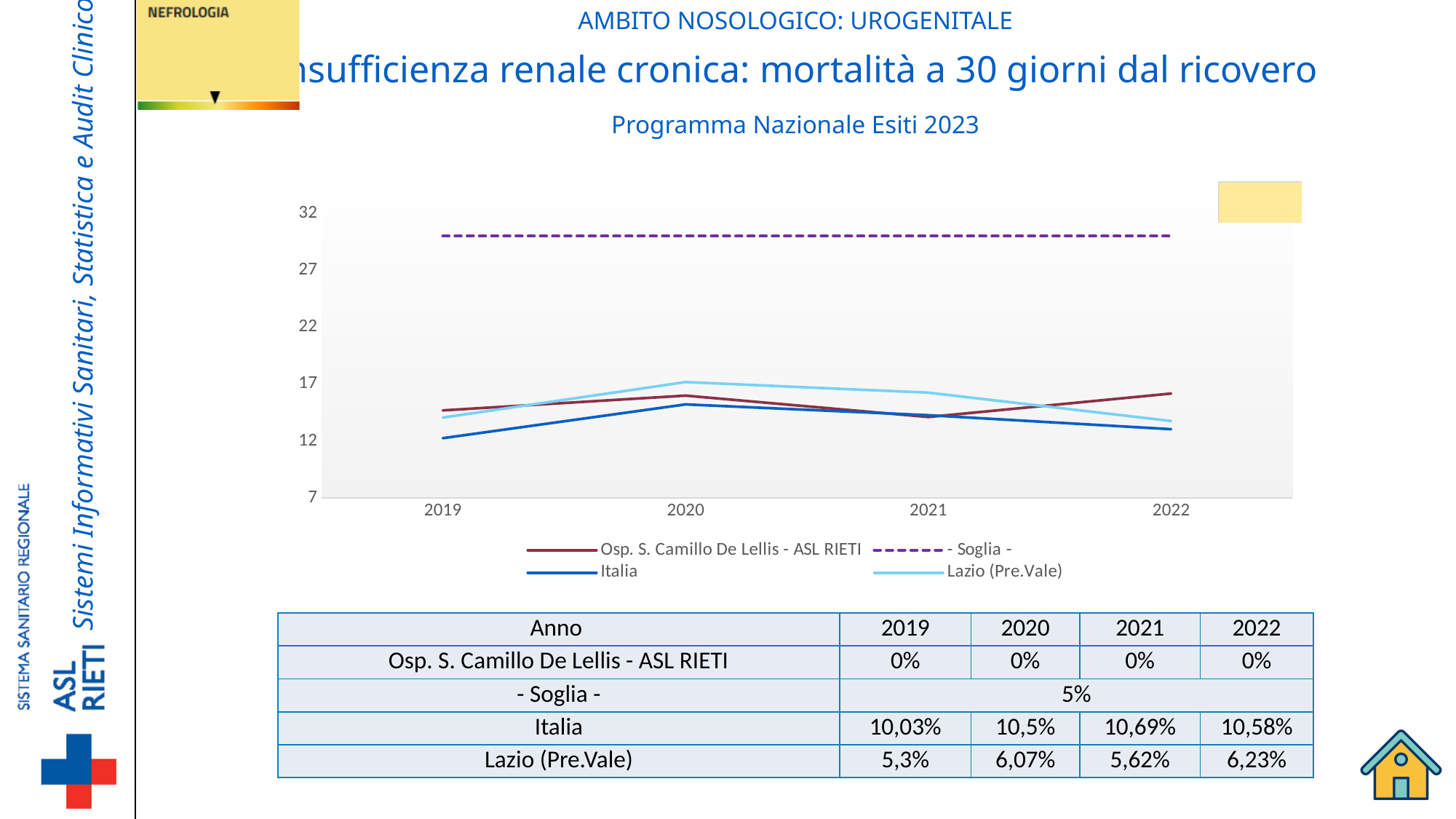
Is the value for Italia in 2019 greater or less than 17? less In which year does the Lazio (Pre.Vale) line reach its highest point? 2020 Which series has the highest values across all years in the chart? - Soglia - How many series does the chart legend list? 4 In 2019, which is higher: Osp. S. Camillo De Lellis - ASL RIETI or Italia? Osp. S. Camillo De Lellis - ASL RIETI Which series in the legend is drawn with a dashed line? - Soglia - Is the value of the - Soglia - line greater or less than 27? greater Does the Italia line rise or fall from 2019 to 2020? rise Is the value for Lazio (Pre.Vale) in 2020 greater or less than 12? greater In which year does the Italia line reach its lowest point? 2019 How many years are shown on the x axis of the chart? 4 What kind of chart is shown on the slide? line chart